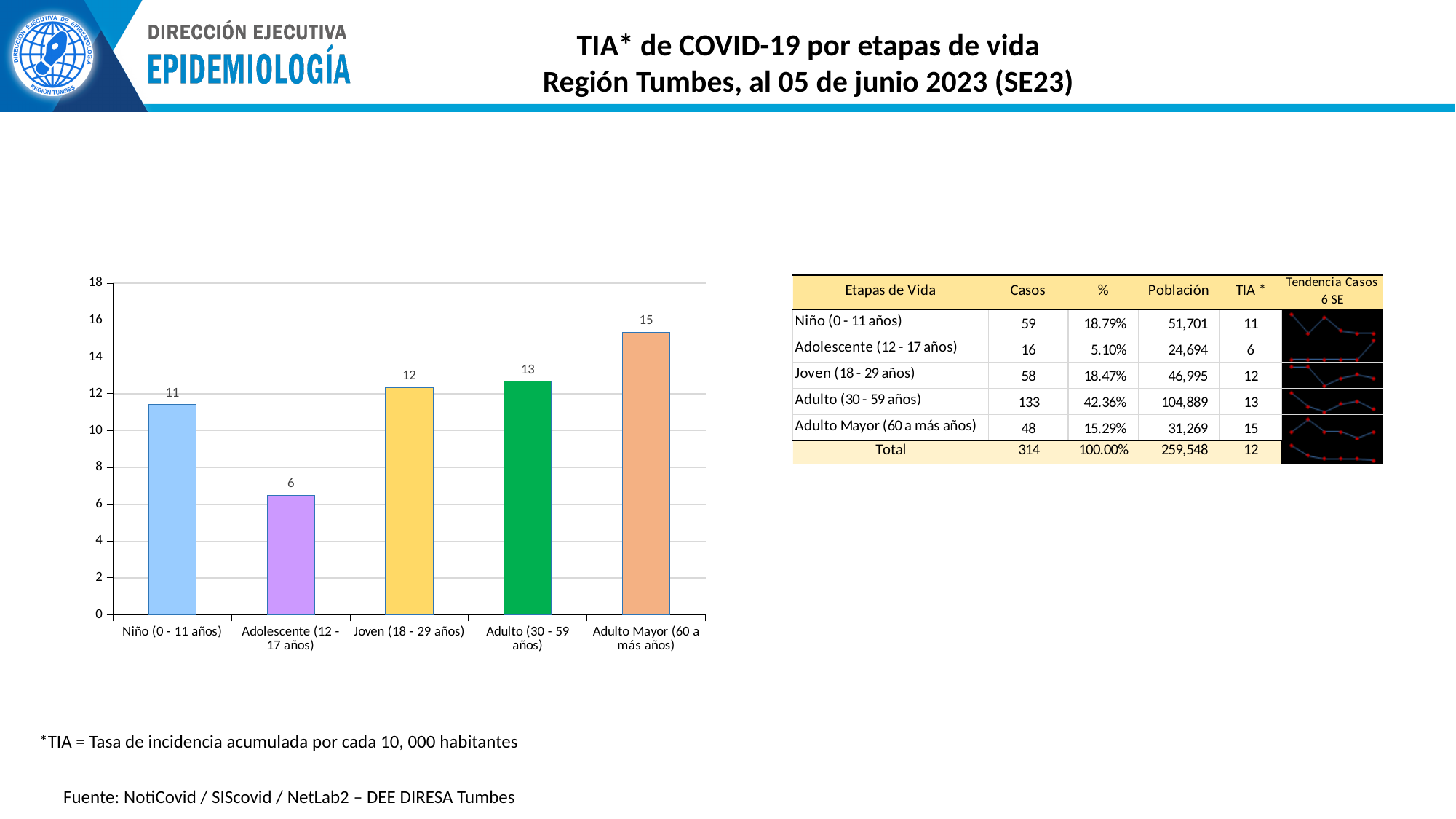
What colour is the bar for Adulto (30 - 59 años)? Green How many life-stage categories are plotted in the bar chart? 5 What is the TIA value shown for Adulto (30 - 59 años) in the bar chart? 13 Is the value for Adolescente (12 - 17 años) greater or less than 8? less What kind of chart is used to show the TIA by life stage? Bar chart Which is larger in the bar chart: the value for Joven (18 - 29 años) or the value for Niño (0 - 11 años)? Joven (18 - 29 años) Which life stage has the lowest bar in the chart? Adolescente (12 - 17 años) What is the difference between the labelled values for Adulto Mayor (60 a más años) and Adolescente (12 - 17 años)? 9 Which life stage has the highest bar in the chart? Adulto Mayor (60 a más años) What is the TIA value shown for Adolescente (12 - 17 años) in the bar chart? 6 What is the TIA value shown for Niño (0 - 11 años) in the bar chart? 11 Is the value for Adulto Mayor (60 a más años) greater or less than 14? greater